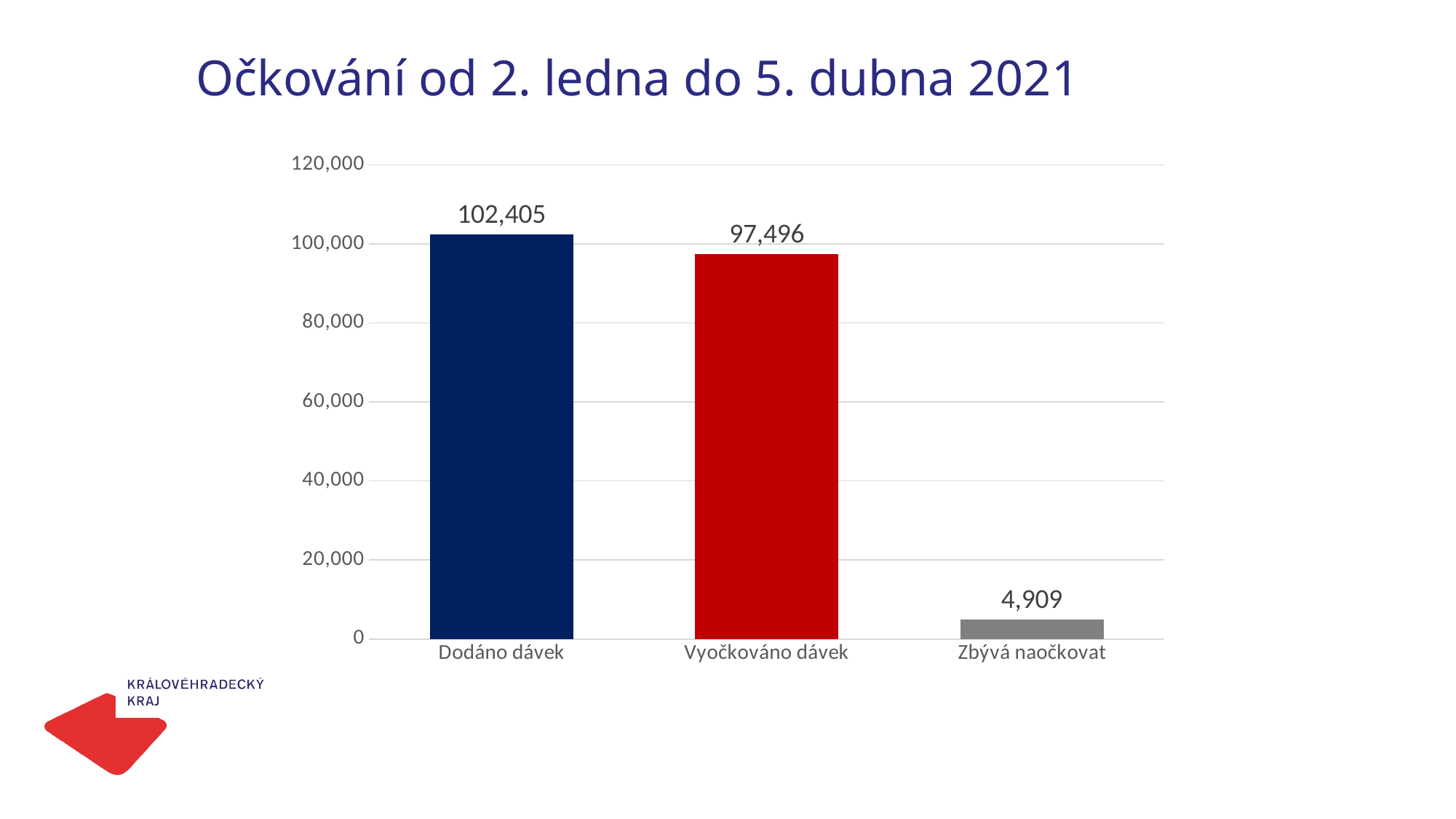
Is the value for Vyočkováno dávek greater or less than 100,000? less What kind of chart is shown on the slide? bar chart What is the value for Zbývá naočkovat? 4,909 What is the title of the slide? Očkování od 2. ledna do 5. dubna 2021 Which category has the lowest value? Zbývá naočkovat What is the difference between Dodáno dávek and Vyočkováno dávek? 4,909 How many categories are shown in the chart? 3 What is the value for Dodáno dávek? 102,405 What colour is the bar for Vyočkováno dávek? red Which category has the highest value? Dodáno dávek What is the value for Vyočkováno dávek? 97,496 Which is larger, Vyočkováno dávek or Zbývá naočkovat? Vyočkováno dávek